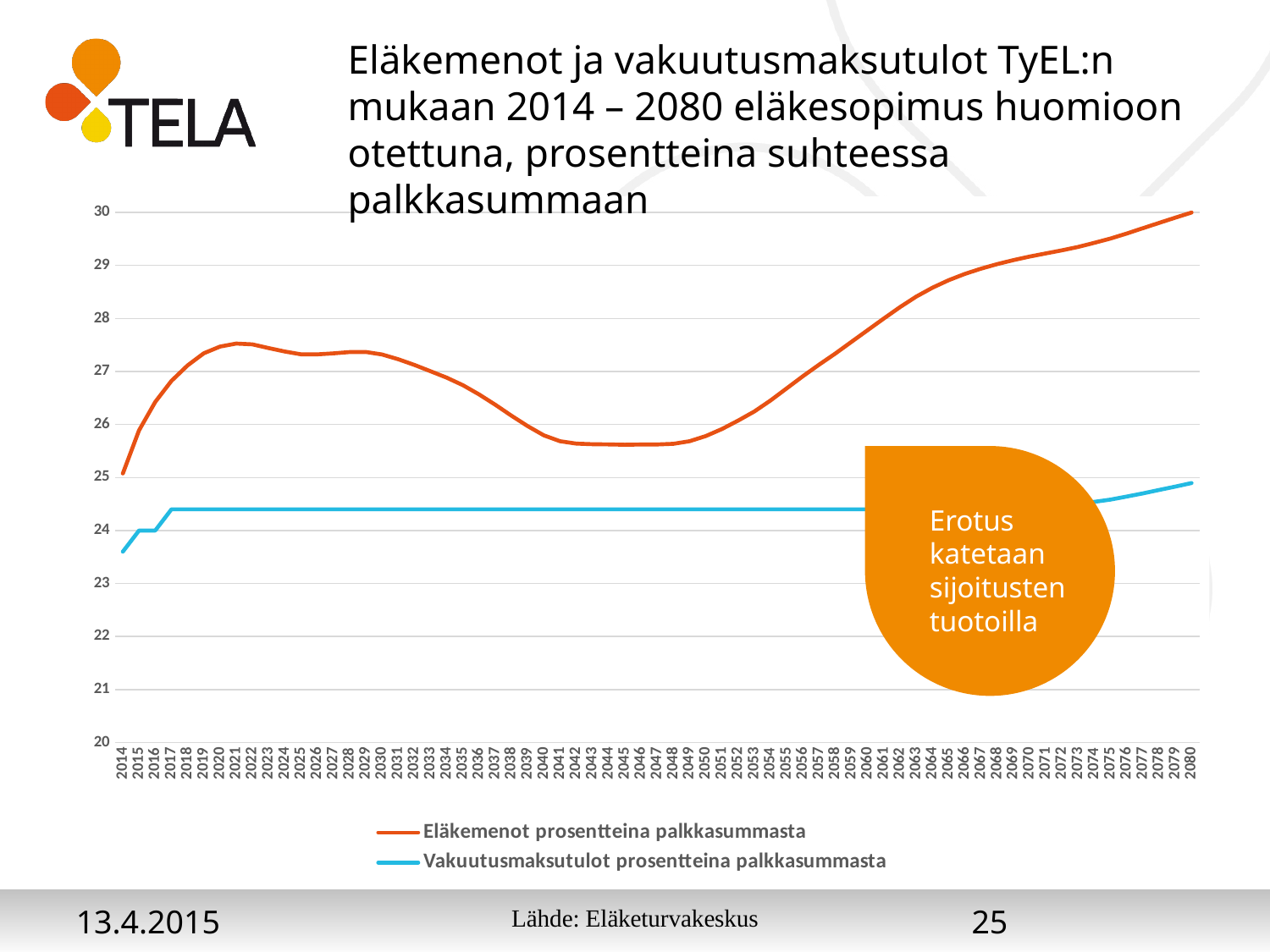
Is the value for Vakuutusmaksutulot prosentteina palkkasummasta in 2014 greater or less than 24? less Is the value for Eläkemenot prosentteina palkkasummasta in 2045 greater or less than 26? less Is the value for Vakuutusmaksutulot prosentteina palkkasummasta in 2030 greater or less than 25? less What is the text inside the orange circle on the chart? Erotus katetaan sijoitusten tuotoilla In which year does Eläkemenot prosentteina palkkasummasta reach its highest value? 2080 What kind of chart is shown on the slide? line chart Does Eläkemenot prosentteina palkkasummasta rise or fall between 2050 and 2080? rise In 2050, which series has the larger value, Eläkemenot or Vakuutusmaksutulot? Eläkemenot How many series does the legend list? 2 Which series is drawn in orange? Eläkemenot prosentteina palkkasummasta